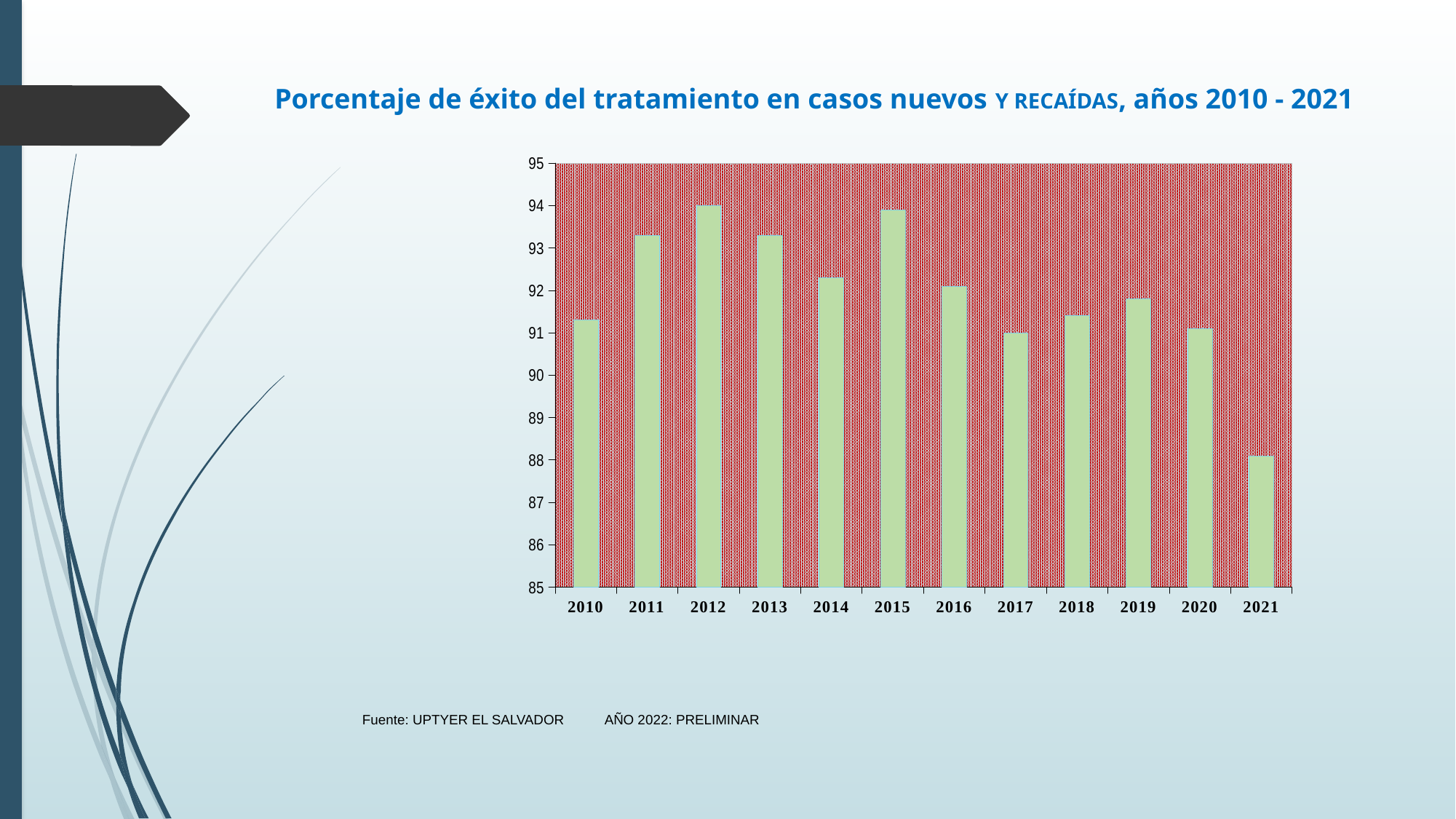
Which year has the larger value, 2020 or 2021? 2020 Do the values rise or fall from 2015 to 2017? fall Which year has the larger value, 2010 or 2011? 2011 What kind of chart is shown on the slide? bar chart Which year has the lowest treatment success percentage? 2021 Is the value for 2012 greater or less than 93? greater Is the value for 2010 greater or less than 90? greater What is the first year shown on the x axis of the chart? 2010 How many years (categories) are plotted on the x axis? 12 Is the value for 2014 greater or less than 93? less